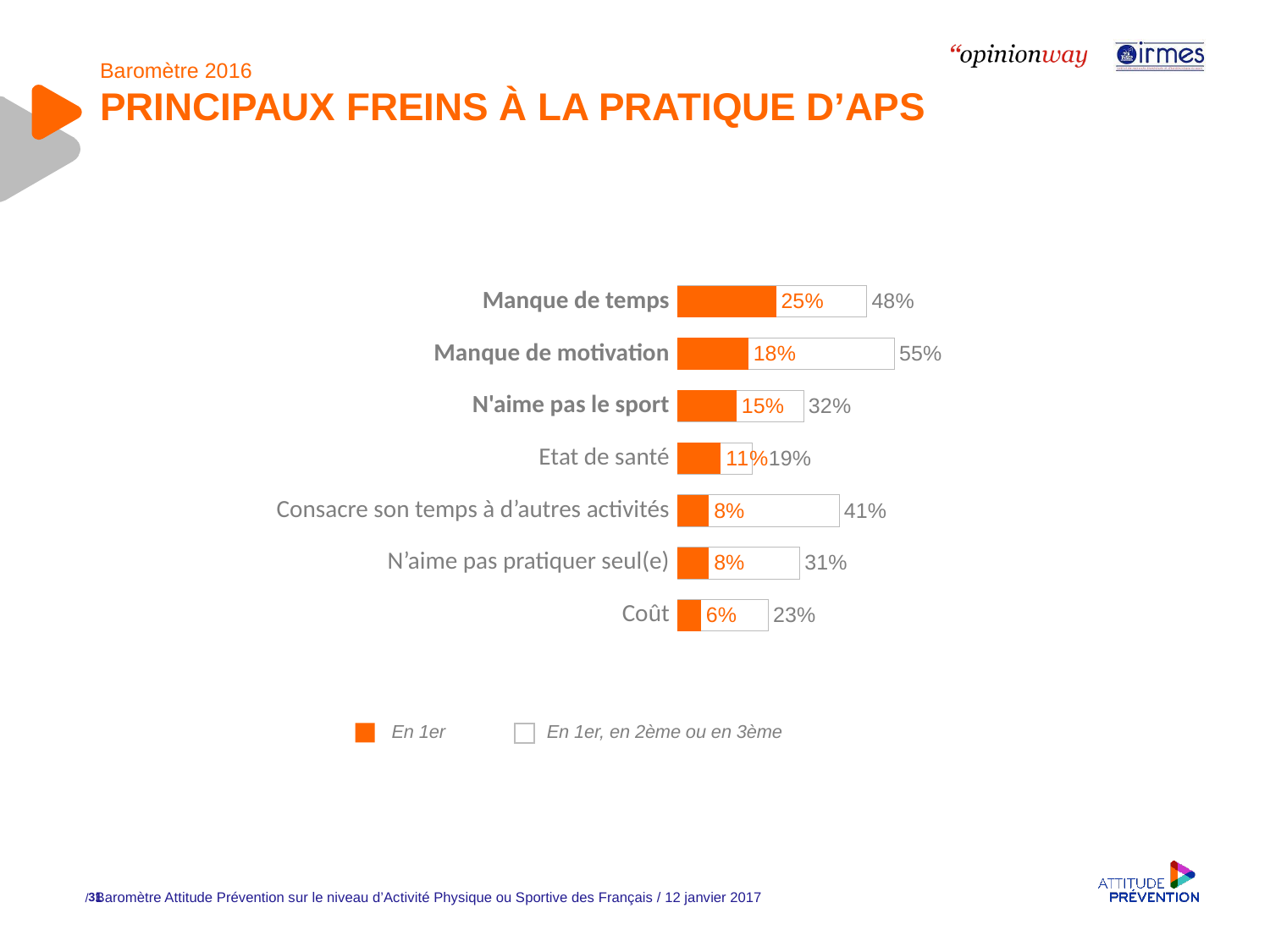
Which category has the lowest 'En 1er, en 2ème ou en 3ème' value? Etat de santé Which is larger: the 'En 1er, en 2ème ou en 3ème' value for N'aime pas le sport or for N'aime pas pratiquer seul(e)? N'aime pas le sport What is the difference between the 'En 1er' values for Manque de temps and Manque de motivation? 7% What is the 'En 1er, en 2ème ou en 3ème' value for Consacre son temps à d'autres activités? 41% How many series does the legend list? 2 What is the 'En 1er' value for Manque de temps? 25% Which category has the highest 'En 1er' value? Manque de temps How many categories are shown in the chart? 7 What is the 'En 1er' value for Coût? 6% Which category has the highest 'En 1er, en 2ème ou en 3ème' value? Manque de motivation What kind of chart is shown on the slide? Bar chart What is the 'En 1er, en 2ème ou en 3ème' value for Manque de motivation? 55%